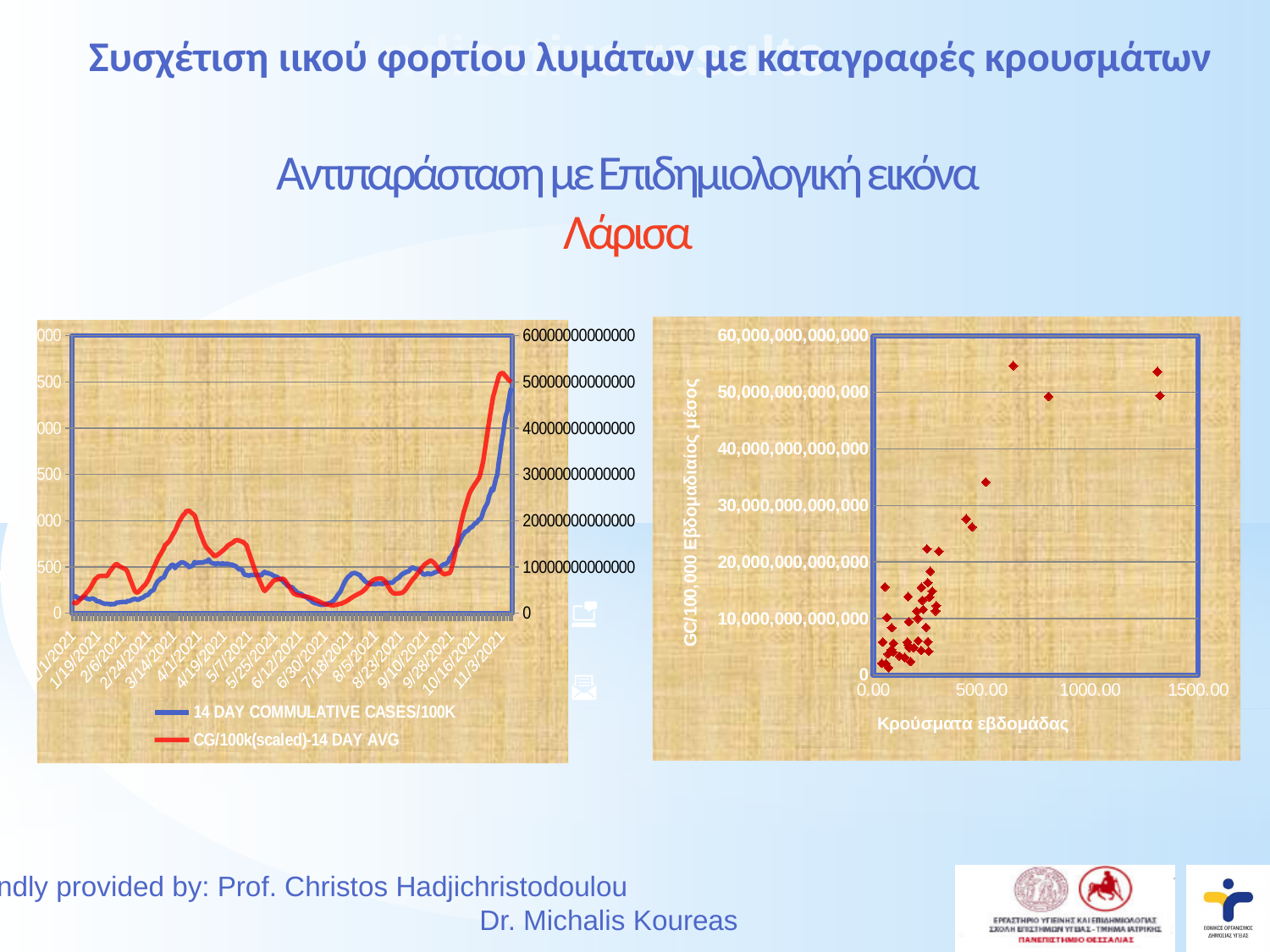
In the left chart, which series is drawn in blue? 14 DAY COMMULATIVE CASES/100K In the right chart, what is the highest value shown on the y axis? 60,000,000,000,000 In the right chart, do the y values generally rise or fall as the x values increase? rise In the left chart, which series is drawn in red? CG/100k(scaled)-14 DAY AVG How many series does the legend of the left chart list? 2 What kind of chart is the chart on the right of the slide? scatter chart In the right chart, what is the label of the x axis? Κρούσματα εβδομάδας In the right chart, are most of the plotted points below or above 20,000,000,000,000 on the y axis? below In the right chart, what is the highest value shown on the x axis? 1500.00 In the left chart, do the two series rise or fall over the last dates shown (toward 11/3/2021)? rise In the right chart, is the highest plotted point greater or less than 50,000,000,000,000 on the y axis? greater What kind of chart is the chart on the left of the slide? line chart